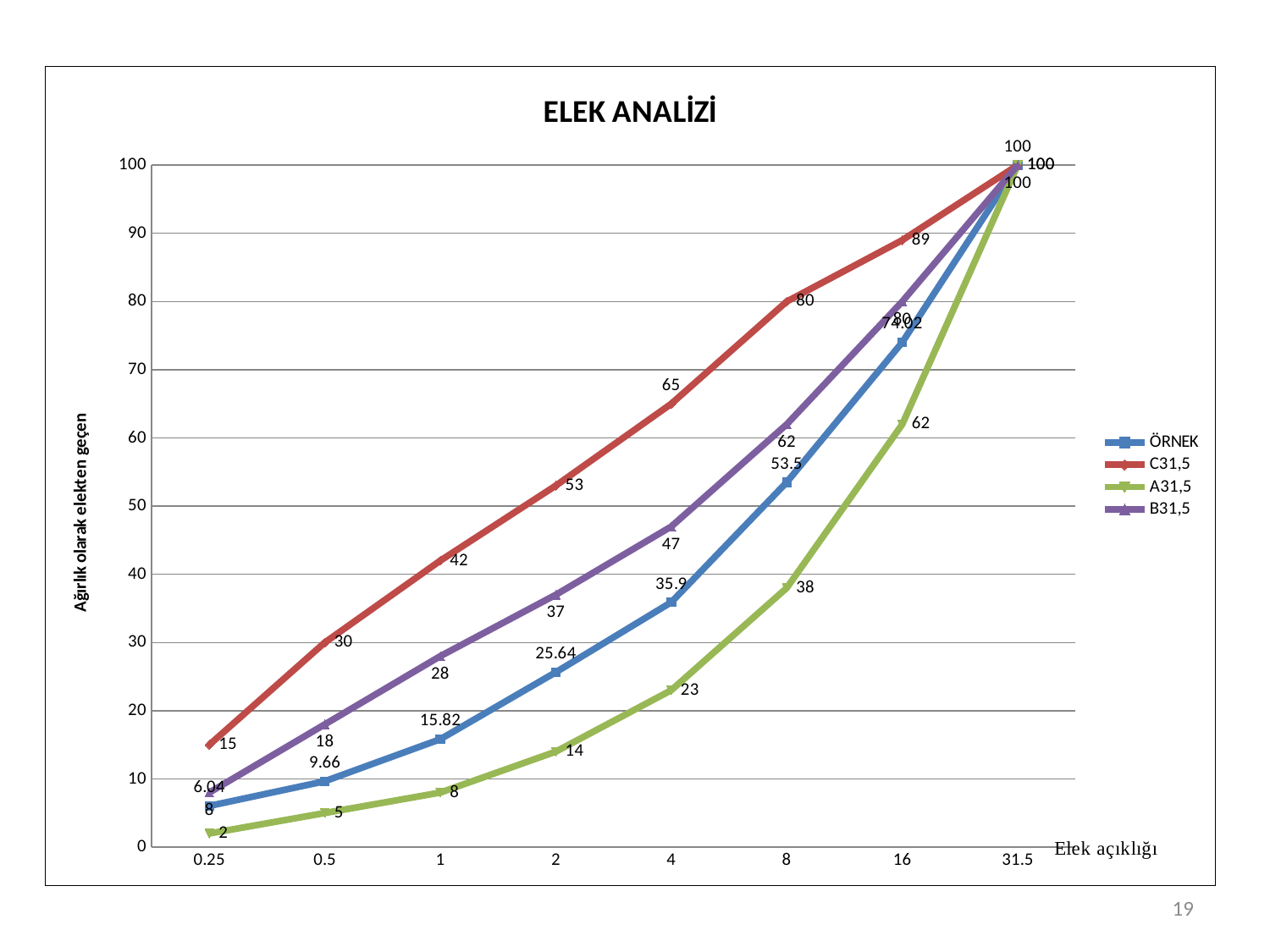
Do the values of the ÖRNEK series rise or fall as the sieve size increases along the x axis? rise What type of chart is shown on the slide? line chart What is the title of the chart? ELEK ANALİZİ How many x-axis categories (sieve sizes) are plotted? 8 How many series does the legend list? 4 Which series has the lowest value at 4? A31,5 What is the value of the A31,5 series at 16? 62 What is the value of the B31,5 series at 2? 37 What is the difference between the C31,5 and A31,5 values at 8? 42 What is the value of the ÖRNEK series at 8? 53.5 What is the value of the C31,5 series at 4? 65 Which series has the highest value at 0.5? C31,5